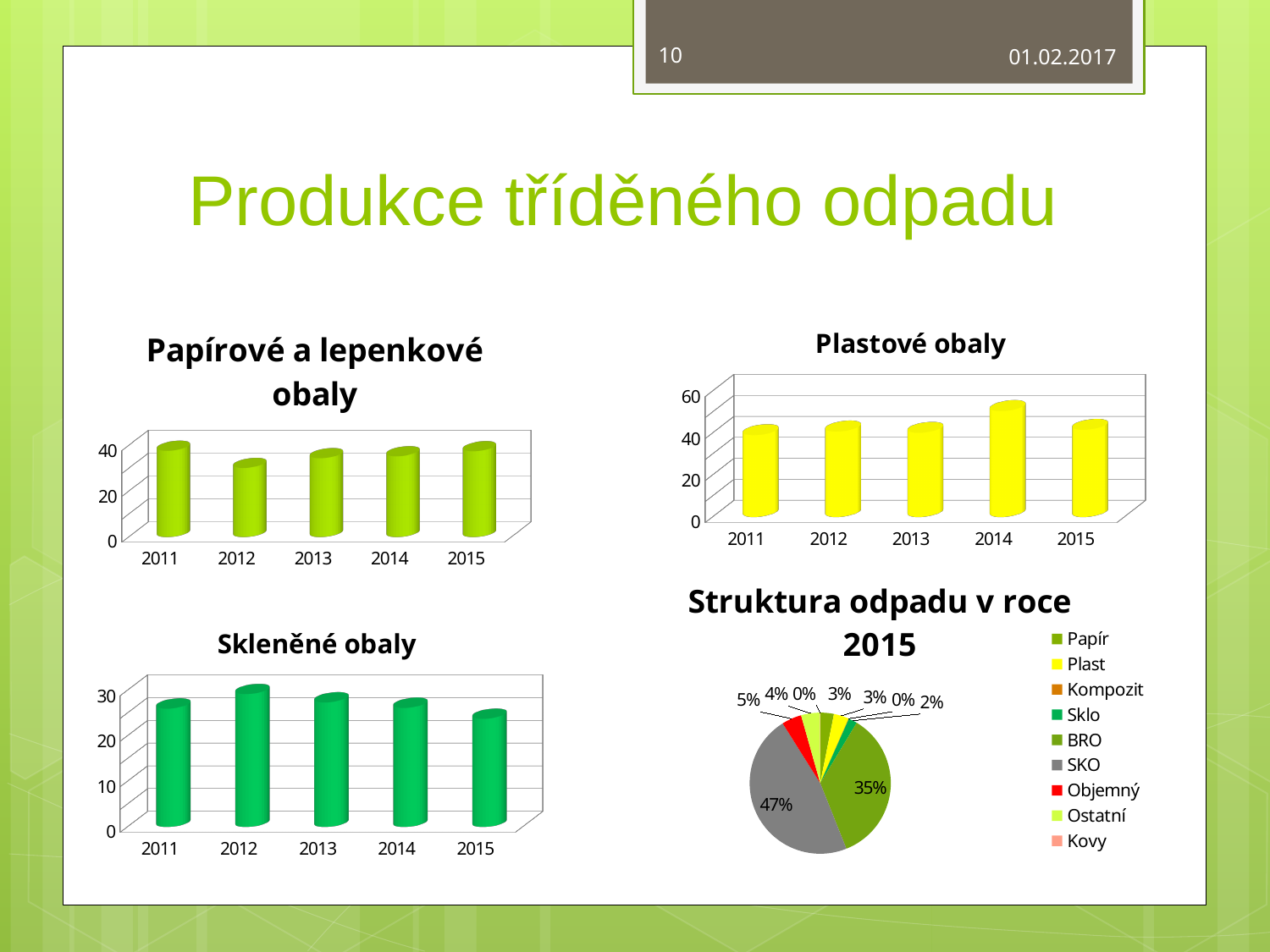
How many entries does the legend of the "Struktura odpadu v roce 2015" chart list? 9 What kind of chart is the "Struktura odpadu v roce 2015" chart? pie chart In the "Struktura odpadu v roce 2015" pie chart, what share does the SKO slice have? 47% In the "Papírové a lepenkové obaly" chart, is the value for 2012 greater or less than 40? less In the "Struktura odpadu v roce 2015" pie chart, what is the largest slice's share? 47% What kind of chart is the "Plastové obaly" chart? bar chart In the "Plastové obaly" chart, which year has the highest value? 2014 In the "Plastové obaly" chart, is the value for 2014 greater or less than 40? greater How many years are shown on the x axis of the "Skleněné obaly" chart? 5 In the "Papírové a lepenkové obaly" chart, which year has the lowest value? 2012 In the "Skleněné obaly" chart, which year has the highest value? 2012 In the "Plastové obaly" chart, which is larger, the value for 2014 or the value for 2011? 2014